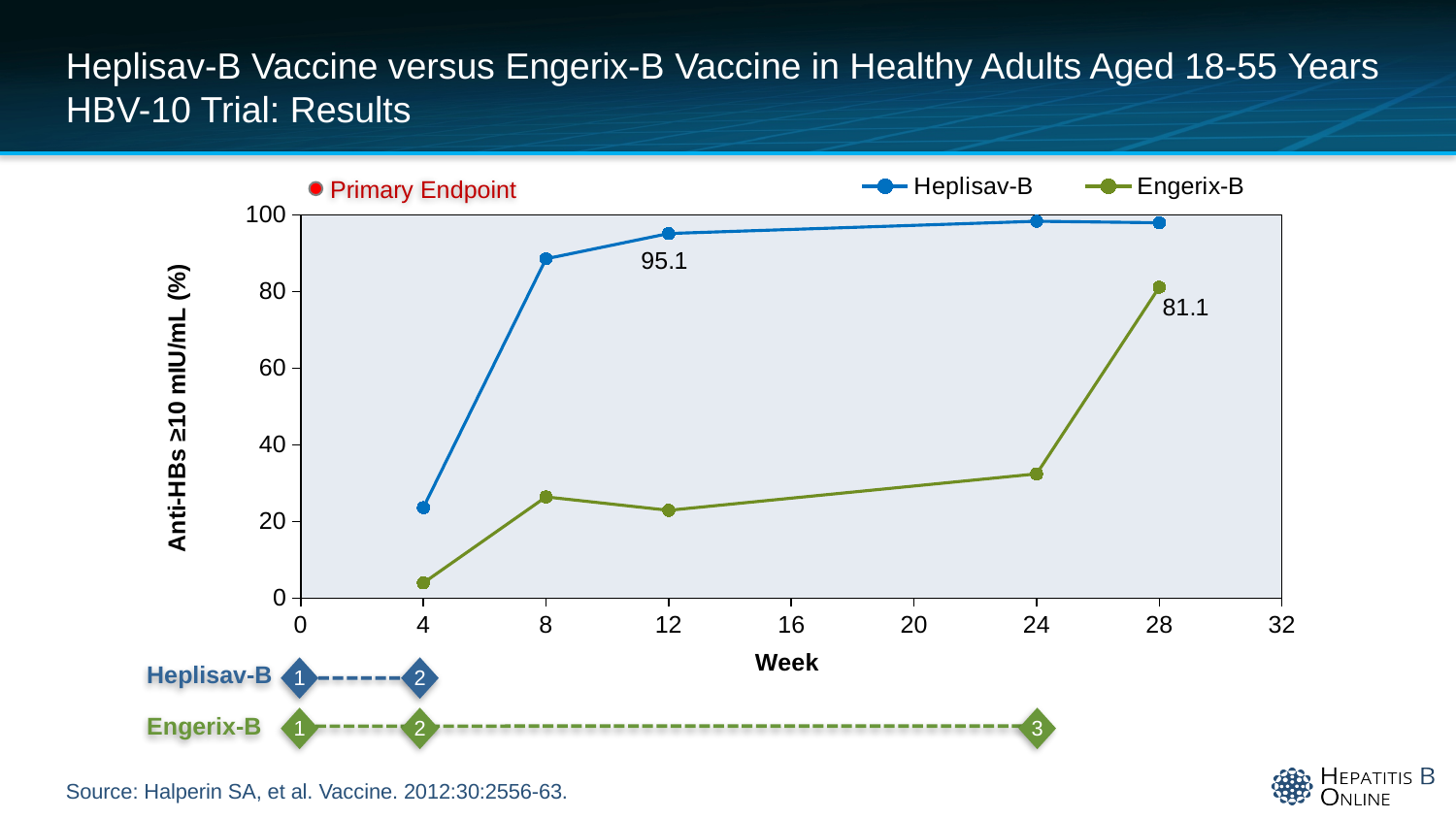
What is the value for Engerix-B at week 28? 81.1 Is the value for Heplisav-B at week 24 greater or less than 80? greater How many data points are plotted for the Engerix-B series? 5 Is the value for Engerix-B at week 4 greater or less than 20? less What is the difference between the Heplisav-B value at week 12 (95.1) and the Engerix-B value at week 28 (81.1)? 14 Does the Engerix-B series rise or fall between week 24 and week 28? Rise What kind of chart is shown on the slide? Line chart What is the label on the y-axis of the chart? Anti-HBs ≥10 mIU/mL (%) At week 8, which series has the higher value, Heplisav-B or Engerix-B? Heplisav-B What is the value for Heplisav-B at week 12? 95.1 Is the value for Engerix-B at week 24 greater or less than 40? less How many series does the legend list? 2